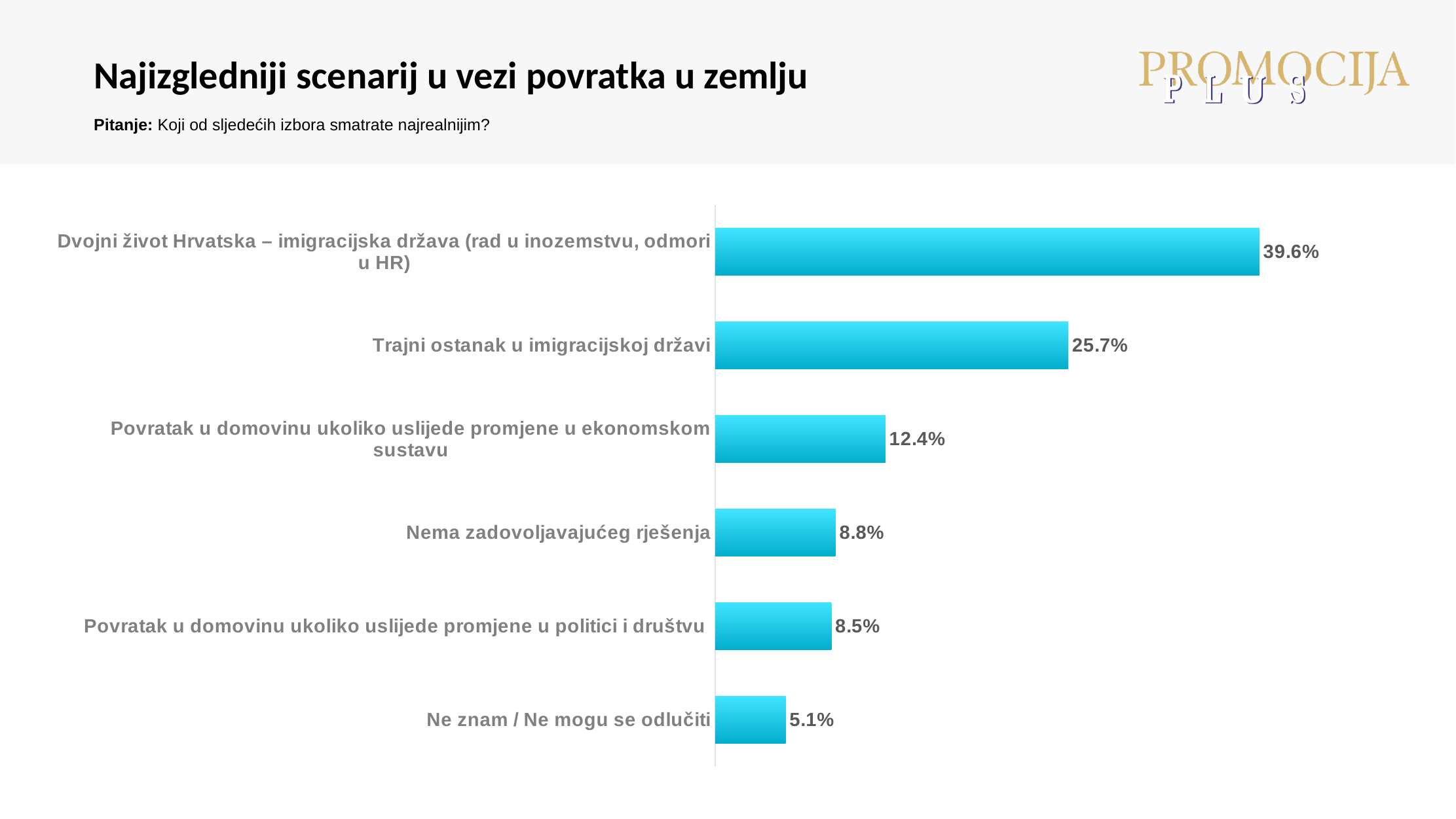
What is the value for "Nema zadovoljavajućeg rješenja"? 8.8% What is the difference between the values for "Dvojni život Hrvatska – imigracijska država (rad u inozemstvu, odmori u HR)" and "Trajni ostanak u imigracijskoj državi"? 13.9% What kind of chart is shown on the slide? Bar chart Which is larger: the value for "Povratak u domovinu ukoliko uslijede promjene u ekonomskom sustavu" or the value for "Nema zadovoljavajućeg rješenja"? Povratak u domovinu ukoliko uslijede promjene u ekonomskom sustavu What is the title of the slide? Najizgledniji scenarij u vezi povratka u zemlju What is the difference between the values for "Nema zadovoljavajućeg rješenja" and "Povratak u domovinu ukoliko uslijede promjene u politici i društvu"? 0.3% Which category has the highest value? Dvojni život Hrvatska – imigracijska država (rad u inozemstvu, odmori u HR) Which category has the lowest value? Ne znam / Ne mogu se odlučiti What is the value for "Ne znam / Ne mogu se odlučiti"? 5.1% What is the value for "Povratak u domovinu ukoliko uslijede promjene u ekonomskom sustavu"? 12.4% What is the value for "Trajni ostanak u imigracijskoj državi"? 25.7% How many categories are shown in the chart? 6